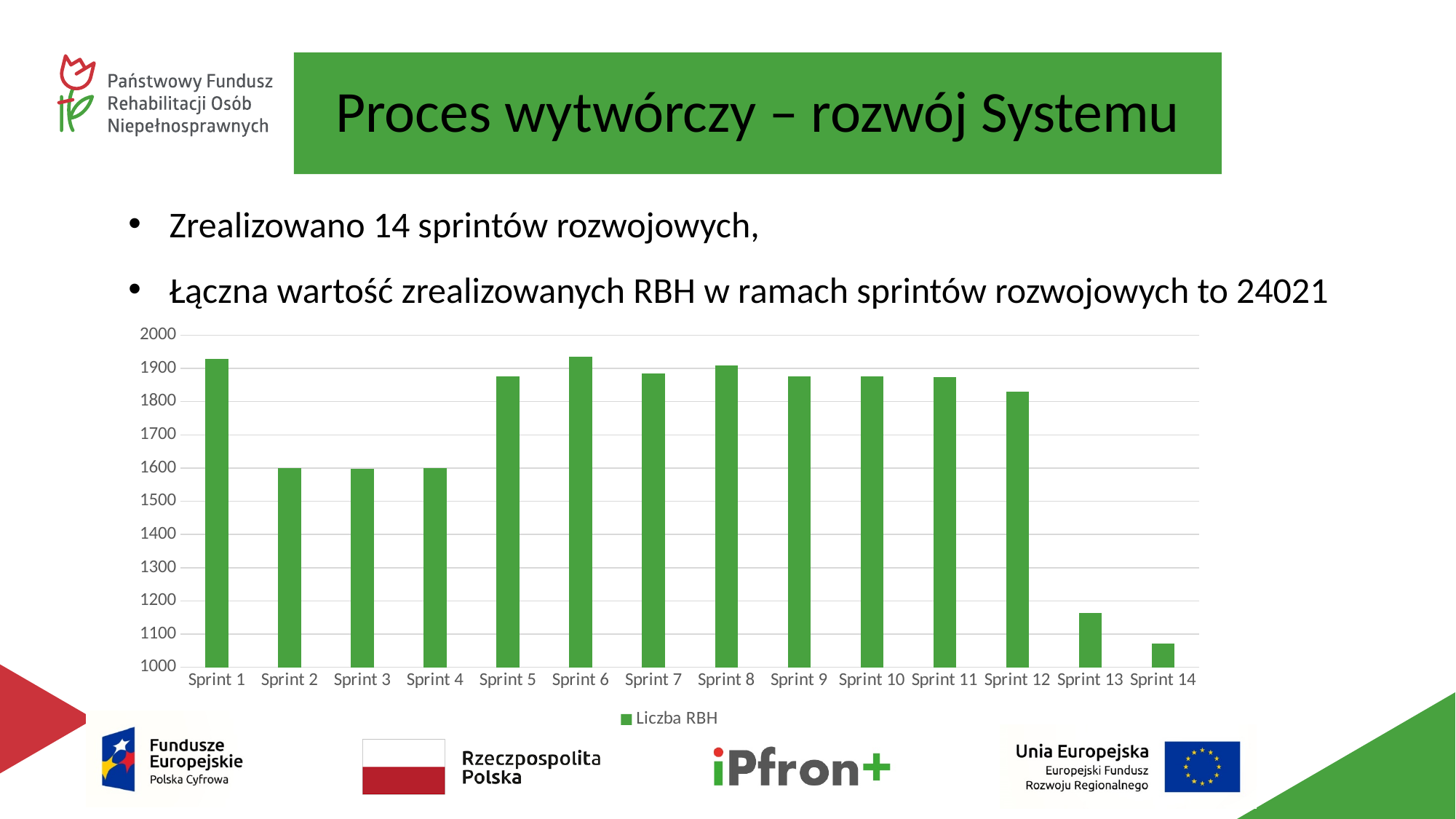
Is the value for Sprint 5 greater or less than 1900? less Which sprint has the lowest value in the chart? Sprint 14 What kind of chart is shown on the slide? bar chart Is the value for Sprint 14 greater or less than 1100? less Is the value for Sprint 13 greater or less than 1200? less How many sprints are shown on the x axis of the chart? 14 Do the values rise or fall from Sprint 12 to Sprint 14? fall How many series does the chart legend list? 1 What is the name of the series shown in the chart legend? Liczba RBH Which has the larger value, Sprint 1 or Sprint 2? Sprint 1